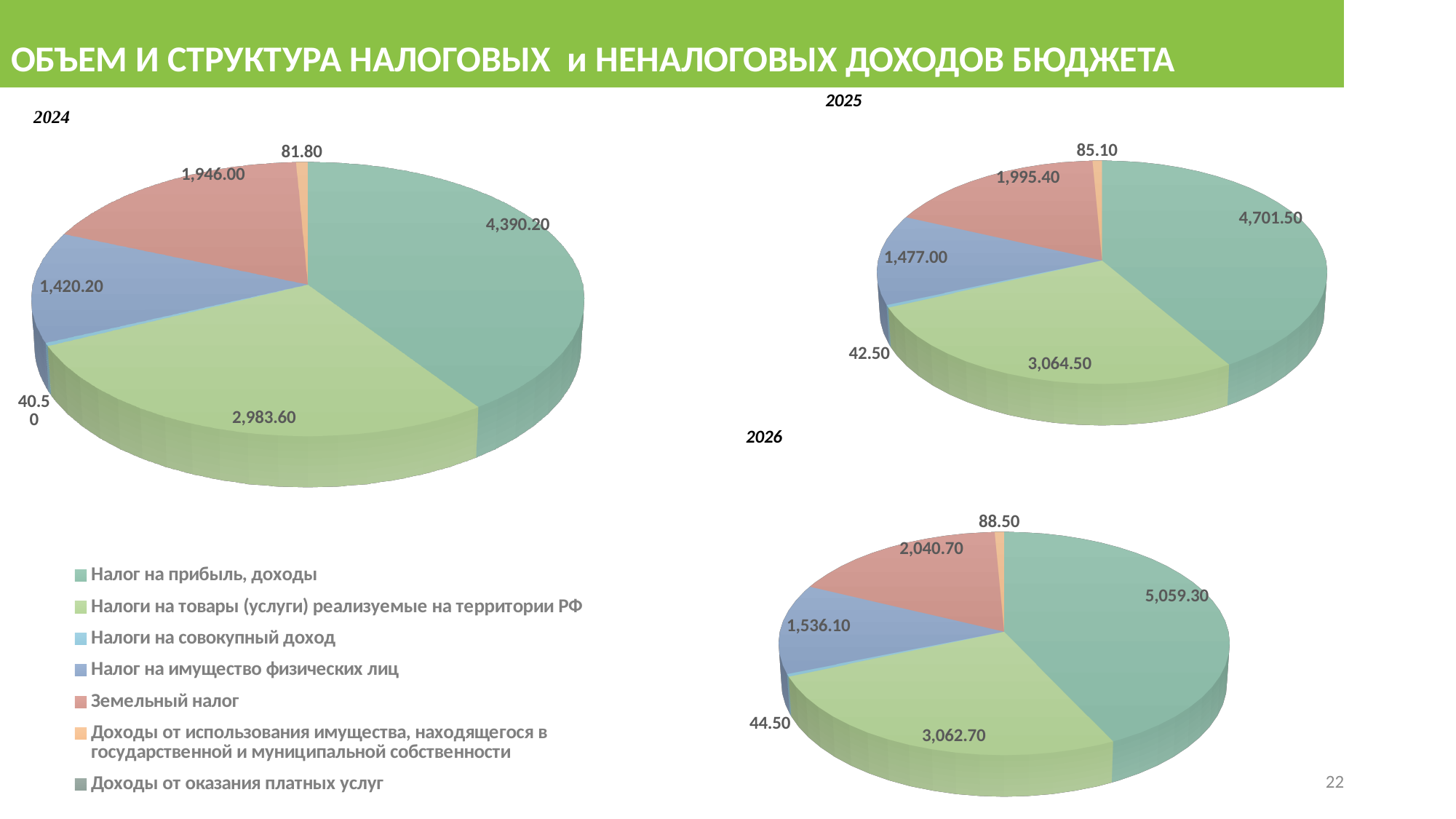
In the 2026 pie chart, what is the value for Налог на имущество физических лиц? 1,536.10 In the 2025 pie chart, what is the value for Земельный налог? 1,995.40 How many categories does the legend list? 7 In the 2026 pie chart, what is the value for Доходы от использования имущества, находящегося в государственной и муниципальной собственности? 88.50 In the 2025 pie chart, what is the value for Налоги на совокупный доход? 42.50 In the 2025 pie chart, what is the difference between Земельный налог and Налог на имущество физических лиц? 518.40 In the 2024 pie chart, what is the value for Налог на прибыль, доходы? 4,390.20 In the 2024 pie chart, which is larger: Земельный налог or Налог на имущество физических лиц? Земельный налог In the 2024 pie chart, which category has the largest slice? Налог на прибыль, доходы In the 2026 pie chart, what is the difference between Налог на прибыль, доходы and Налоги на товары (услуги) реализуемые на территории РФ? 1,996.60 In the 2026 pie chart, which category has the smallest labelled slice? Налоги на совокупный доход What type of chart is used for the 2025 data? Pie chart